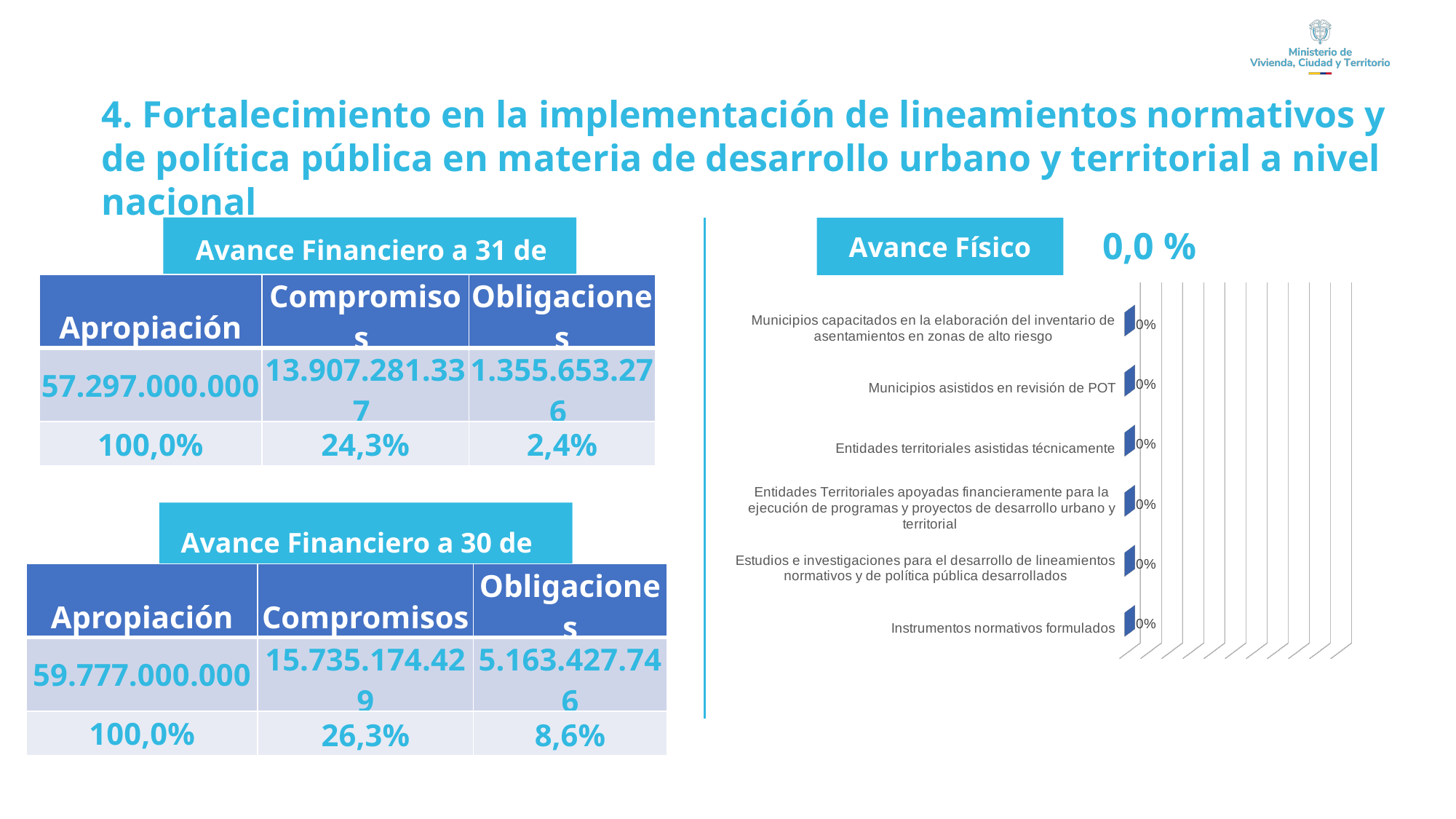
In the "Avance Físico" chart, what is the difference between the value for "Municipios asistidos en revisión de POT" and the value for "Instrumentos normativos formulados"? 0% What kind of chart is shown under the "Avance Físico" heading? bar chart How many categories are plotted in the "Avance Físico" bar chart? 6 In the "Avance Físico" chart, what is the value for "Entidades territoriales asistidas técnicamente"? 0% In the "Avance Físico" chart, which category is listed at the bottom of the chart? Instrumentos normativos formulados What is the overall percentage shown next to the "Avance Físico" heading above the chart? 0,0 % In the "Avance Físico" chart, what is the value for "Instrumentos normativos formulados"? 0% What is the heading shown above the bar chart on the right side of the slide? Avance Físico In the "Avance Físico" chart, what is the value for "Estudios e investigaciones para el desarrollo de lineamientos normativos y de política pública desarrollados"? 0% In the "Avance Físico" chart, what is the value for "Municipios asistidos en revisión de POT"? 0% In the "Avance Físico" chart, what is the value for "Municipios capacitados en la elaboración del inventario de asentamientos en zonas de alto riesgo"? 0%